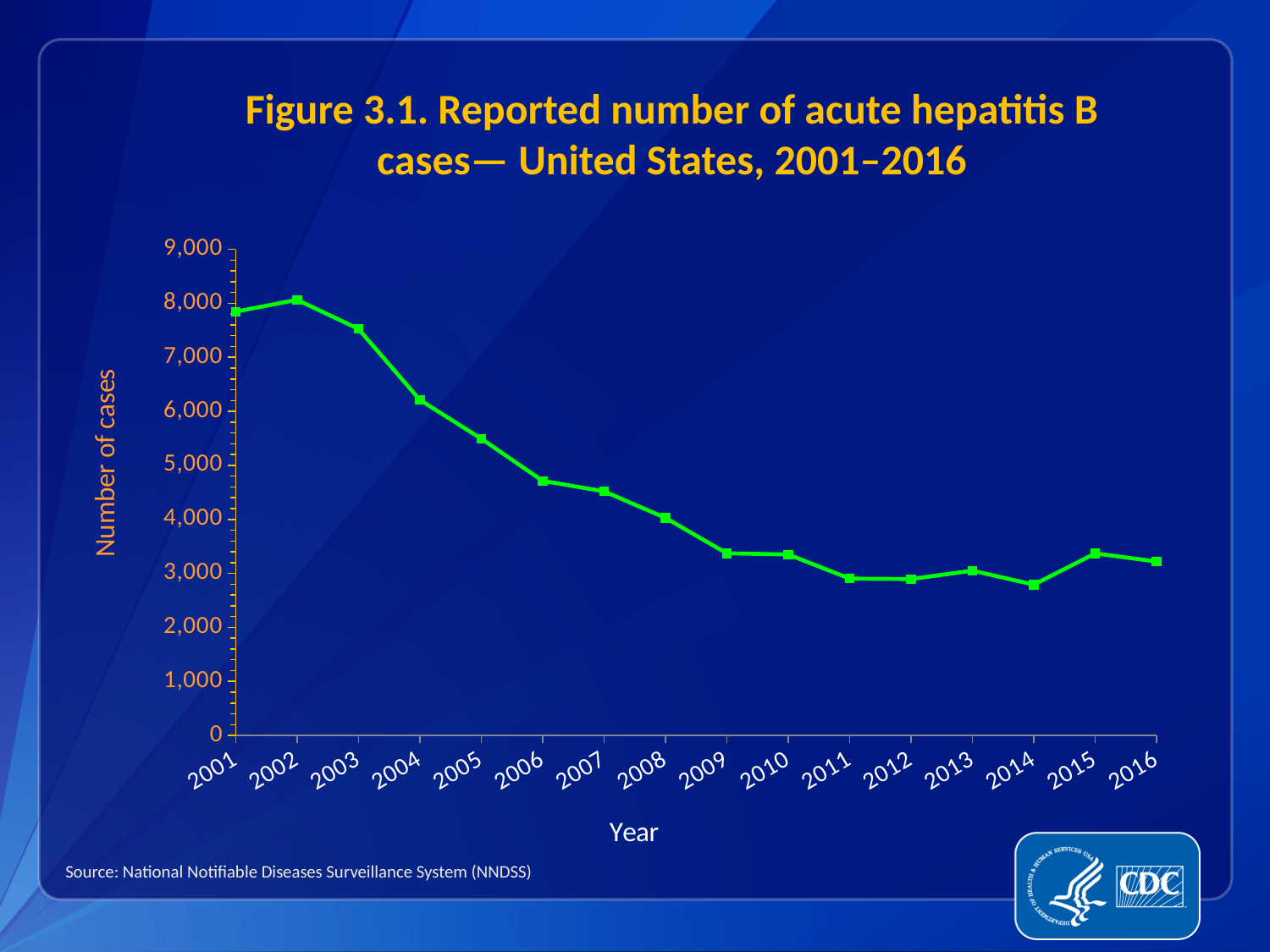
What is the label of the x axis? Year Which year has more reported cases, 2003 or 2015? 2003 Is the value for 2004 greater or less than 6,000? greater What is the label of the y axis? Number of cases Is the value for 2014 greater or less than 3,000? less Is the value for 2006 greater or less than 5,000? less In which year was the reported number of acute hepatitis B cases highest? 2002 Overall, do the reported cases rise or fall from 2001 to 2016? Fall What kind of chart is shown on the slide? Line chart How many years are plotted on the x axis? 16 Which year has more reported cases, 2004 or 2008? 2004